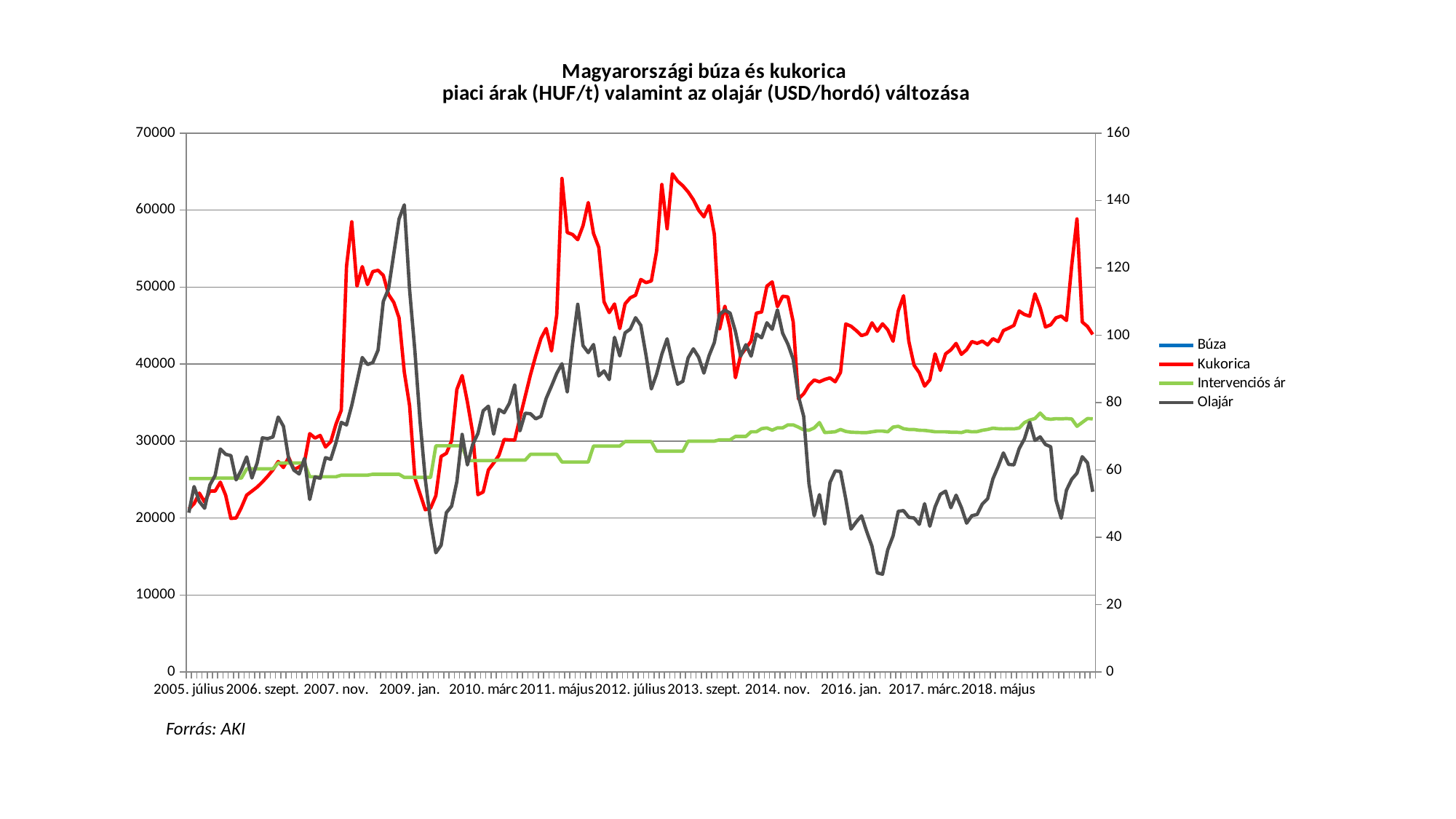
What kind of chart is shown on the slide? line chart Is the value for Kukorica at 2005. július greater or less than 30000? less Is the value for Intervenciós ár at 2005. július greater or less than 30000? less How many series does the legend list? 4 Is the highest value reached by the Olajár line greater or less than 120? greater What colour is the Kukorica line in the legend? red Does the Intervenciós ár line generally rise or fall from 2005. július to 2018. május? rise Which series reaches the highest value on the left axis? Kukorica What is the title of the chart? Magyarországi búza és kukorica piaci árak (HUF/t) valamint az olajár (USD/hordó) változása